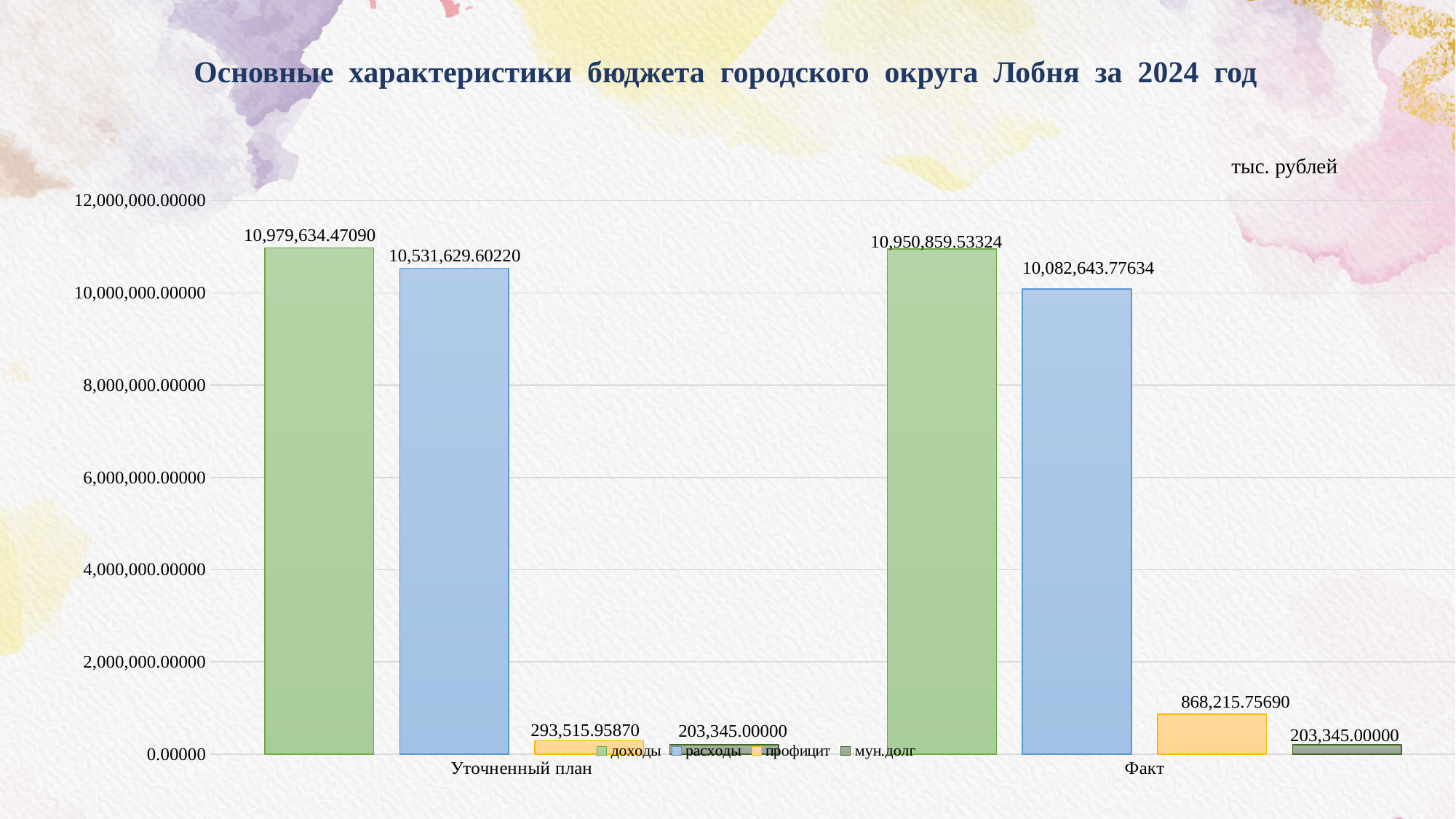
Which series has the lowest value in the Уточненный план category? мун.долг What is the difference between расходы for Уточненный план and расходы for Факт? 448,985.82586 What is the value of мун.долг for Уточненный план? 203,345.00000 What is the value of доходы for Уточненный план? 10,979,634.47090 What kind of chart is shown on the slide? bar chart How many categories are shown on the x axis? 2 What is the value of профицит for Факт? 868,215.75690 How many series does the legend list? 4 Which series has the highest value in the Факт category? доходы What is the difference between профицит for Факт and профицит for Уточненный план? 574,699.79820 What is the value of расходы for Факт? 10,082,643.77634 Which is larger: доходы for Уточненный план or доходы for Факт? доходы for Уточненный план